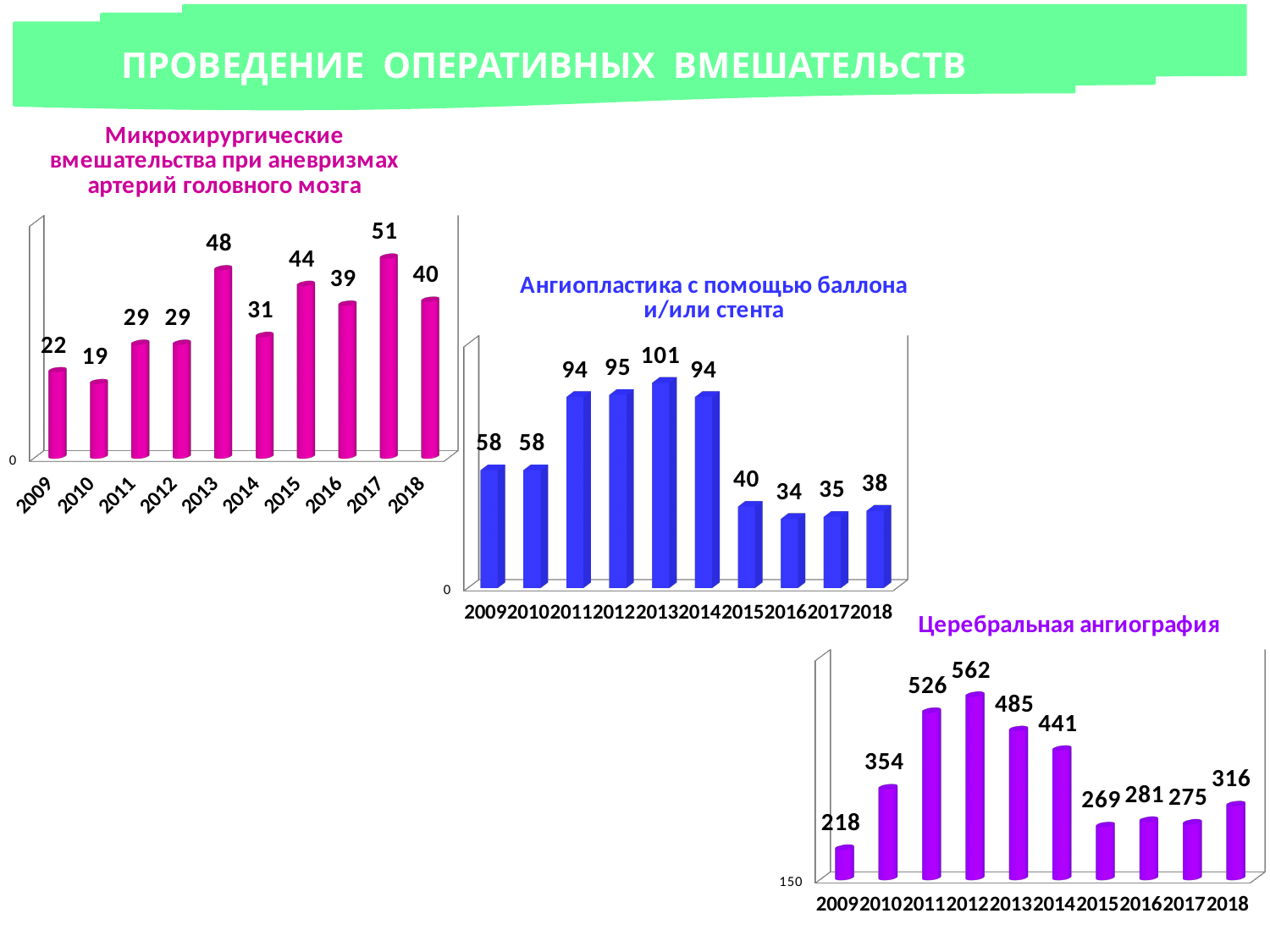
In the chart titled 'Ангиопластика с помощью баллона и/или стента', which is larger, the value for 2014 or the value for 2015? 2014 In the chart titled 'Церебральная ангиография', what is the difference between the values for 2011 and 2010? 172 In the chart titled 'Микрохирургические вмешательства при аневризмах артерий головного мозга', which year has the lowest value? 2010 In the chart titled 'Церебральная ангиография', what is the value for 2012? 562 In the chart titled 'Ангиопластика с помощью баллона и/или стента', what is the value for 2013? 101 In the chart titled 'Микрохирургические вмешательства при аневризмах артерий головного мозга', what is the value for 2013? 48 In the chart titled 'Микрохирургические вмешательства при аневризмах артерий головного мозга', which year has the highest value? 2017 In the chart titled 'Микрохирургические вмешательства при аневризмах артерий головного мозга', what is the difference between the values for 2017 and 2018? 11 In the chart titled 'Ангиопластика с помощью баллона и/или стента', how many years are shown on the x axis? 10 In the chart titled 'Ангиопластика с помощью баллона и/или стента', which year has the lowest value? 2016 In the chart titled 'Церебральная ангиография', which year has the lowest value? 2009 What kind of chart is the chart titled 'Церебральная ангиография'? Bar chart